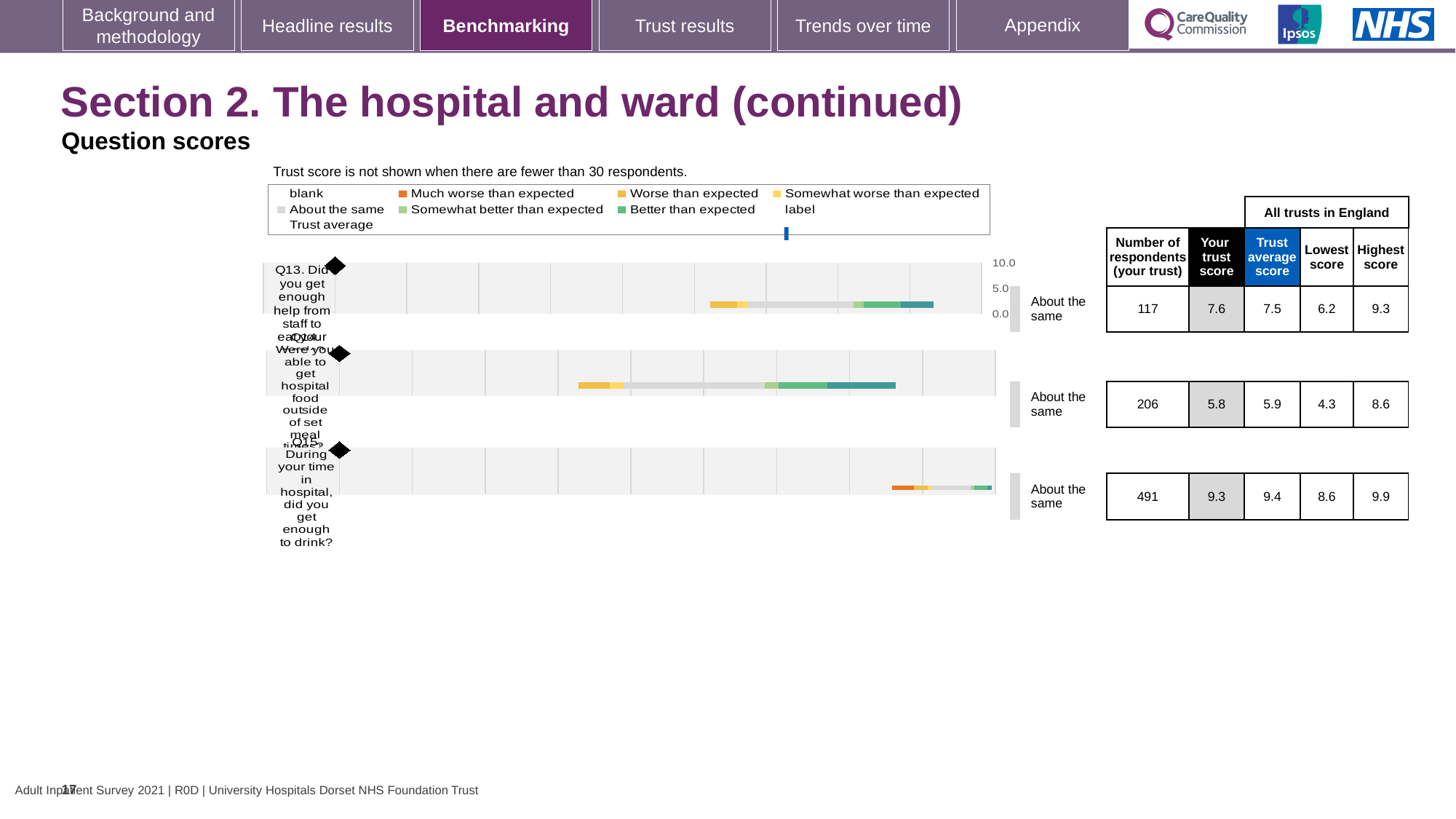
What kind of chart is used to show the question scores? Bar chart What benchmark category is shown for Q13? About the same What is the highest score across all trusts in England for Q15 (did you get enough to drink?)? 9.9 What is the lowest score across all trusts in England for Q14? 4.3 What is the trust score for Q13 (Did you get enough help from staff to eat your meals?)? 7.6 Which question has the lowest trust score for this trust? Q14 What is the difference between the trust score and the trust average score for Q13? 0.1 How many respondents answered Q14 (Were you able to get hospital food outside of set meal times?) at this trust? 206 Which question has the highest trust score for this trust? Q15 For Q14, which is larger: this trust's score or the trust average score? Trust average score How many questions are plotted on the chart? 3 What is the difference between the highest and lowest scores in England for Q15? 1.3